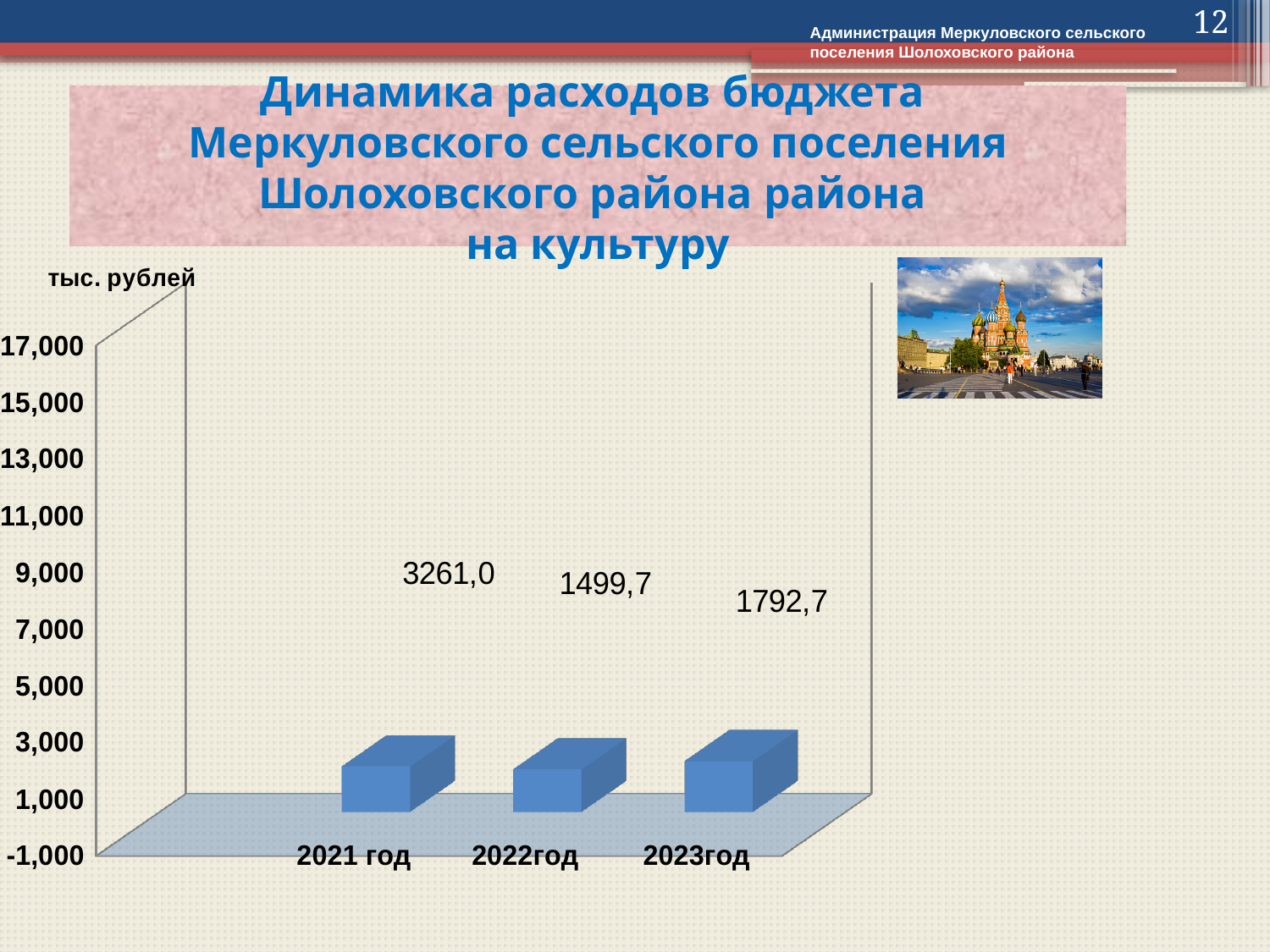
What kind of chart is shown on the slide? bar chart Which is larger, the value for 2022год or the value for 2023год? 2023год How many years are shown on the chart? 3 What unit is given for the vertical axis of the chart? тыс. рублей What is the value for 2023год? 1792,7 Which year has the lowest value? 2022год What is the value for 2022год? 1499,7 What is the difference between the values for 2023год and 2022год? 293,0 Is the value for 2021 год greater or less than 5,000? less What is the value for 2021 год? 3261,0 What is the difference between the values for 2021 год and 2022год? 1761,3